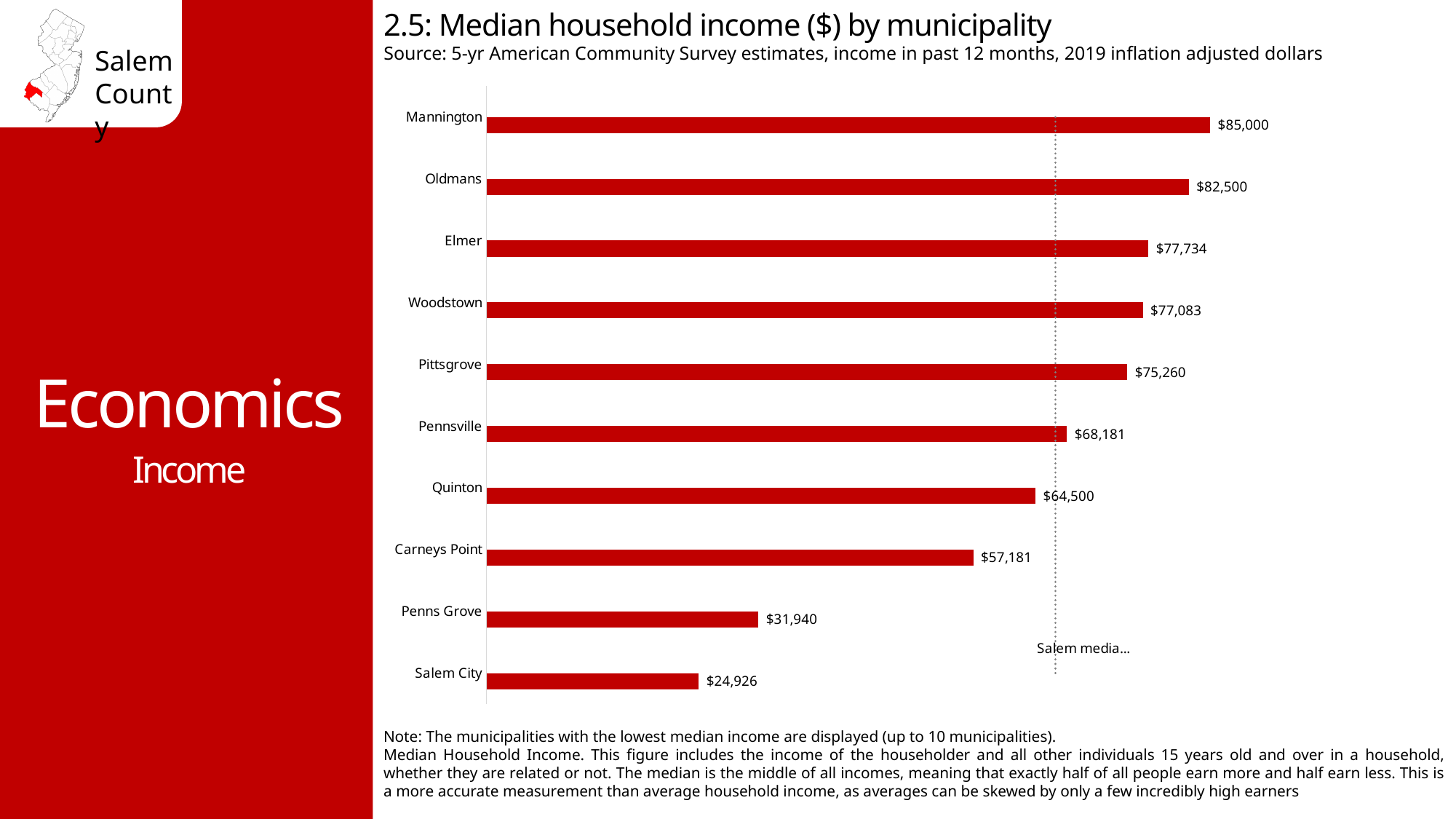
How many municipalities are shown on the chart? 10 What is the difference in median household income between Mannington and Oldmans? $2,500 What kind of chart is used to show median household income by municipality? Bar chart What is the difference in median household income between Penns Grove and Salem City? $7,014 Which municipality has the lowest median household income on the chart? Salem City Which has a higher median household income, Woodstown or Pittsgrove? Woodstown What is the median household income for Penns Grove? $31,940 Which municipality has the highest median household income on the chart? Mannington Which has a higher median household income, Pennsville or Carneys Point? Pennsville What is the title of the chart? 2.5: Median household income ($) by municipality What is the median household income for Mannington? $85,000 What is the median household income for Quinton? $64,500